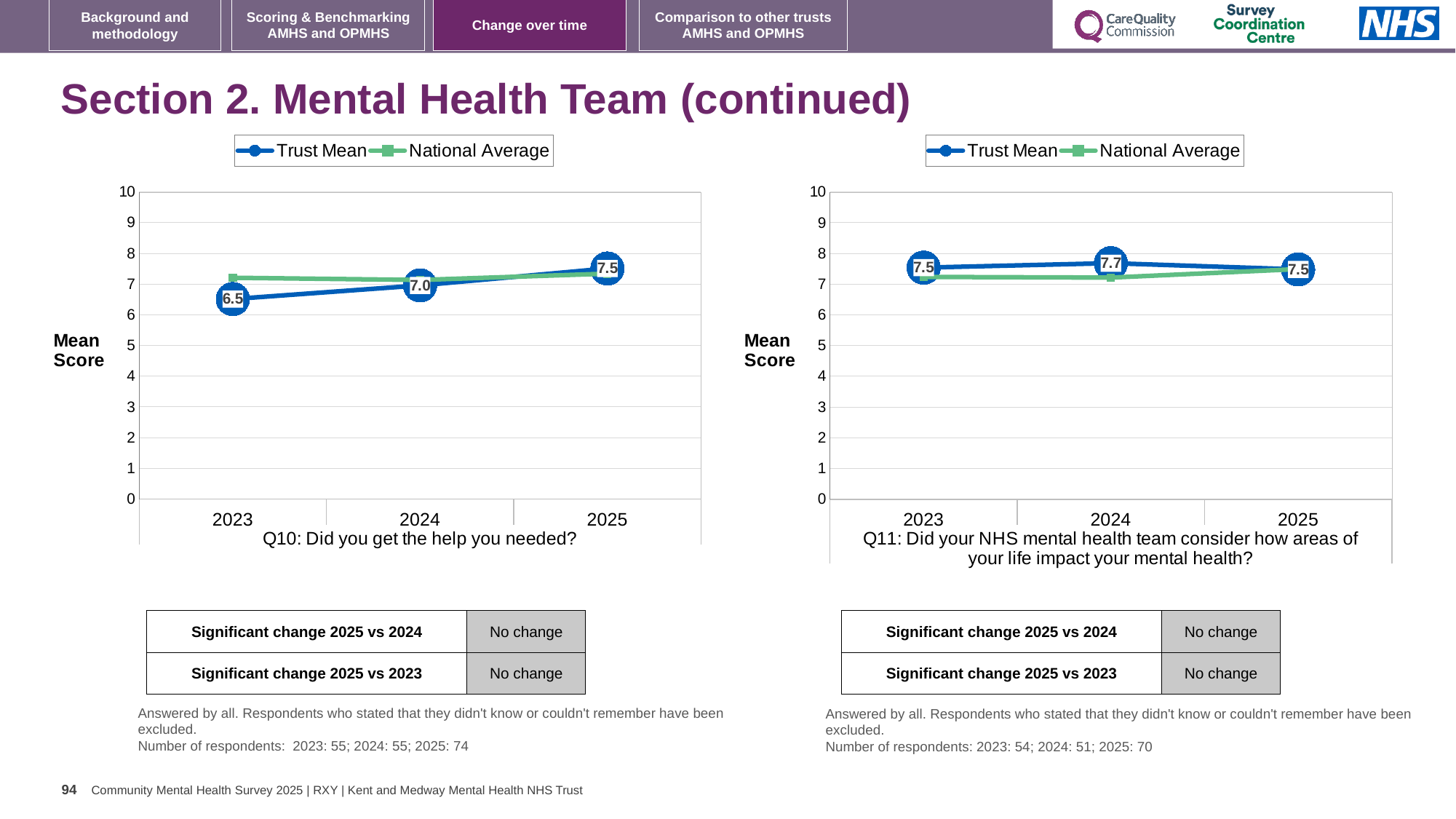
On the Q10 chart (left), what is the Trust Mean score for 2023? 6.5 On the Q10 chart (left), is the National Average value for 2023 greater or less than 6? greater On the Q10 chart (left), what is the Trust Mean score for 2025? 7.5 On the Q11 chart (right), what is the Trust Mean score for 2024? 7.7 How many years are shown on the x axis of the Q11 chart (right)? 3 How many series does the legend of the Q10 chart (left) list? 2 On the Q10 chart (left), what is the difference between the Trust Mean scores for 2025 and 2023? 1.0 On the Q10 chart (left), which year has the lowest Trust Mean score? 2023 On the Q11 chart (right), which year has the highest Trust Mean score? 2024 On the Q11 chart (right), which is larger, the Trust Mean for 2024 or the Trust Mean for 2023? 2024 What kind of chart is the Q11 chart (right)? line chart On the Q10 chart (left), does the Trust Mean rise or fall from 2023 to 2025? rise